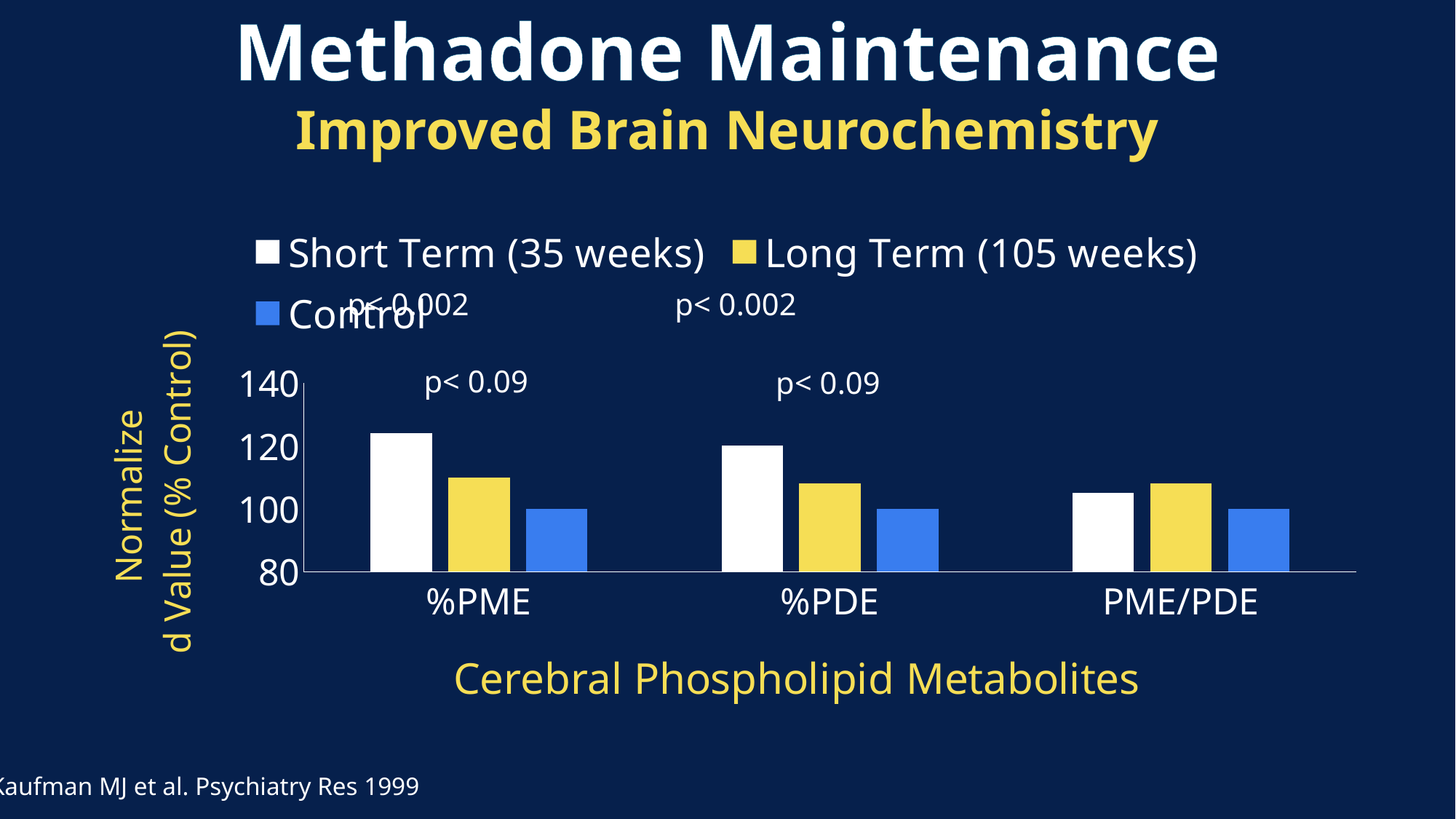
Is the Long Term (105 weeks) value for %PME greater or less than 120? less How many series does the legend list? 3 For PME/PDE, which is larger: Short Term (35 weeks) or Long Term (105 weeks)? Long Term (105 weeks) How many categories are shown on the x axis? 3 For %PME, which is larger: Short Term (35 weeks) or Long Term (105 weeks)? Short Term (35 weeks) Which series has the lowest value for %PDE? Control Is the Long Term (105 weeks) value for %PDE greater or less than 100? greater What is the x-axis title of the chart? Cerebral Phospholipid Metabolites What is the Control value for PME/PDE? 100 Is the Short Term (35 weeks) value for %PME greater or less than 120? greater What kind of chart is shown on the slide? bar chart What is the Control value for %PME? 100